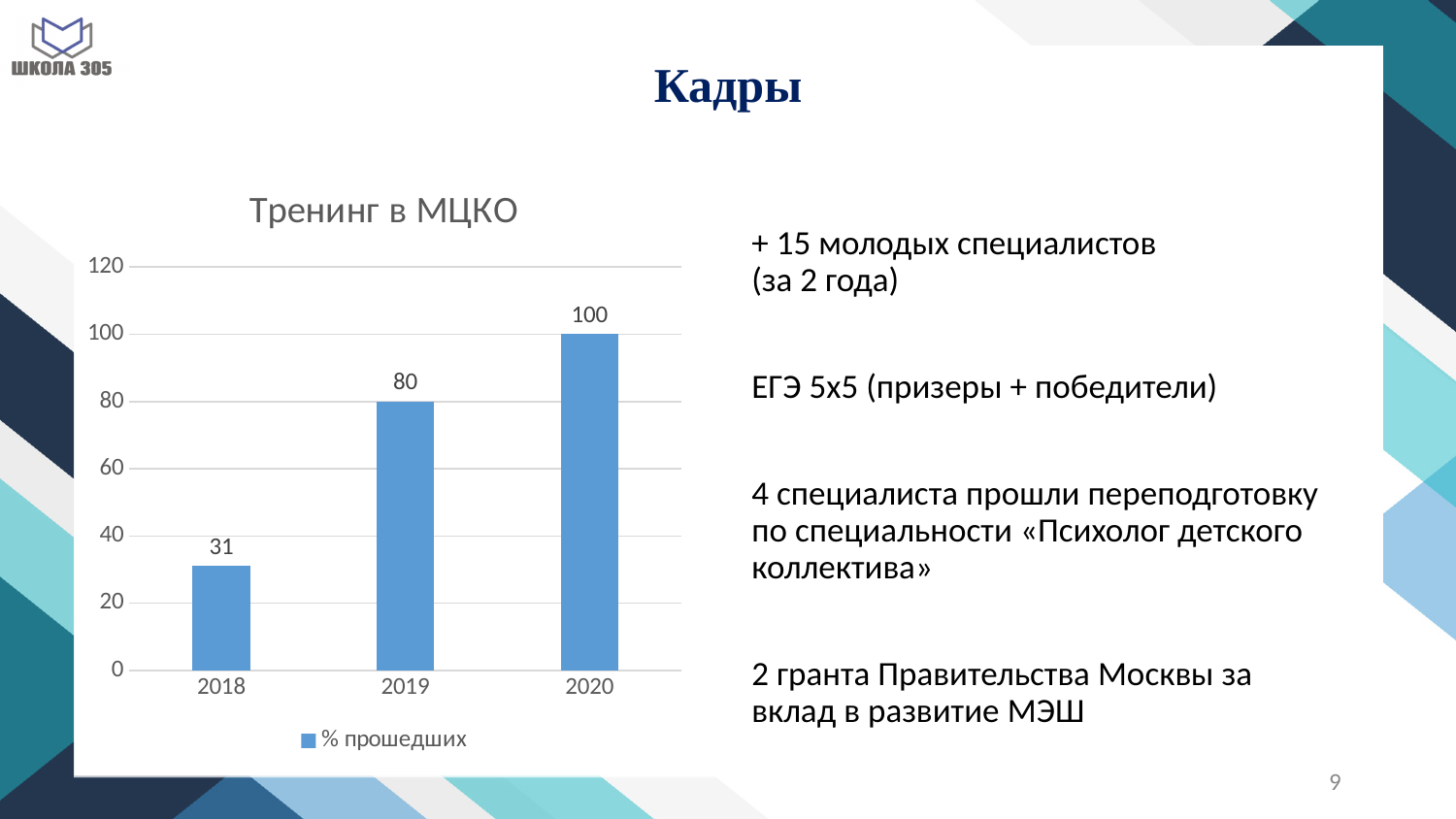
Which year has the highest value in the chart? 2020 What is the value for 2020 in the chart? 100 What is the value for 2018 in the chart? 31 How many years are shown on the x axis of the chart? 3 What is the difference between the values for 2019 and 2018? 49 Which is larger, the value for 2019 or the value for 2018? 2019 Which year has the lowest value in the chart? 2018 What is the difference between the values for 2020 and 2018? 69 How many series does the legend list? 1 What is the value for 2019 in the chart? 80 Do the values rise or fall from 2018 to 2020? rise What kind of chart is shown on the slide? bar chart